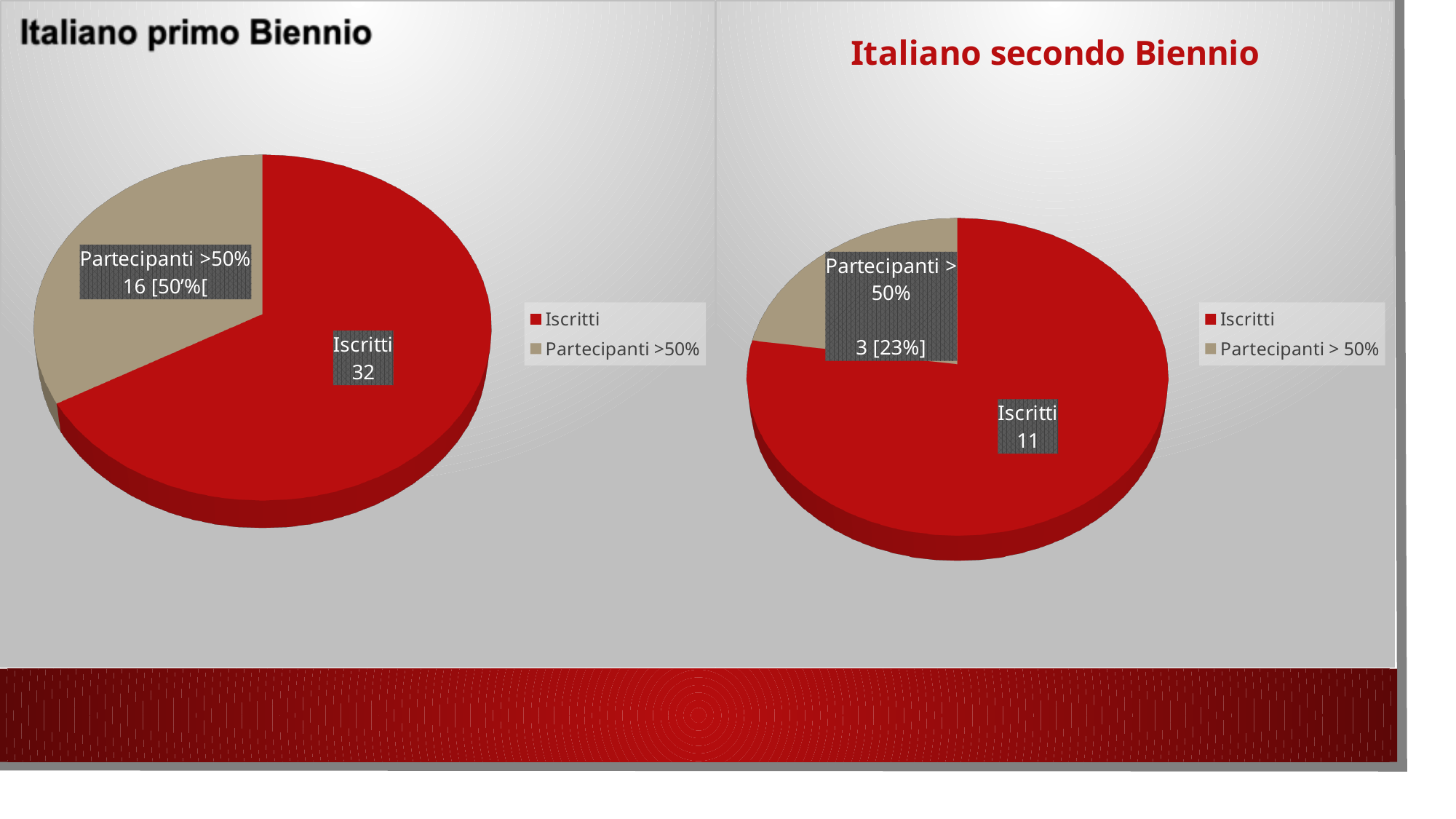
In the 'Italiano secondo Biennio' chart, what percentage is printed in the label for Partecipanti > 50%? 23% In the 'Italiano primo Biennio' chart, what is the value for Iscritti? 32 In the 'Italiano secondo Biennio' chart, which slice is the smallest? Partecipanti > 50% How many entries does the legend of the 'Italiano secondo Biennio' chart list? 2 In the 'Italiano secondo Biennio' chart, what is the difference between Iscritti and Partecipanti > 50%? 8 What kind of chart is 'Italiano primo Biennio'? Pie chart In the 'Italiano primo Biennio' chart, what is the value for Partecipanti >50%? 16 In the 'Italiano secondo Biennio' chart, what is the value for Iscritti? 11 In the 'Italiano secondo Biennio' chart, what is the value for Partecipanti > 50%? 3 In the 'Italiano primo Biennio' chart, what is the difference between Iscritti and Partecipanti >50%? 16 In the 'Italiano primo Biennio' chart, which slice is the largest? Iscritti Which chart has the larger Iscritti value, 'Italiano primo Biennio' or 'Italiano secondo Biennio'? Italiano primo Biennio